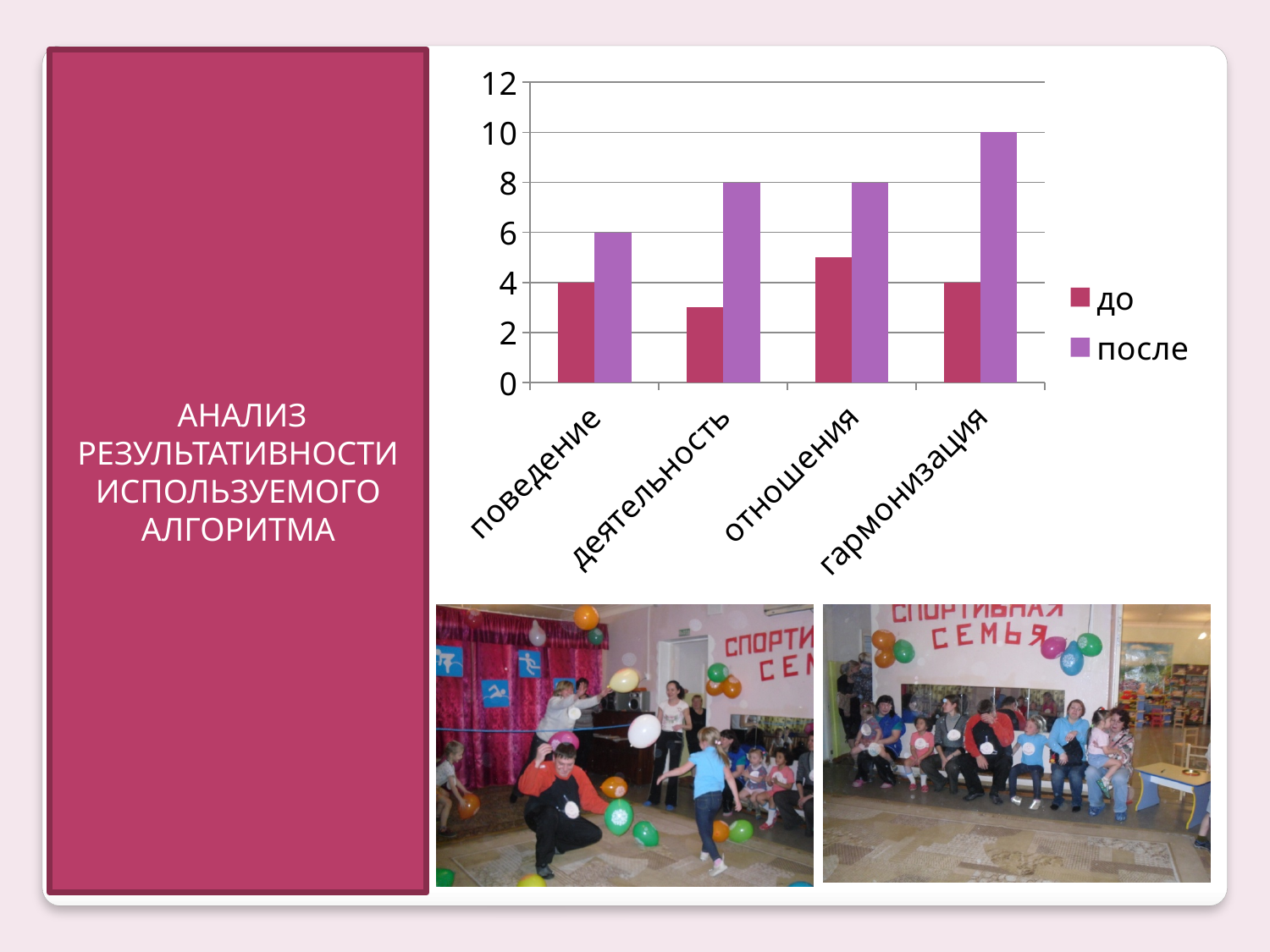
Which is larger: the "после" value for гармонизация or the "после" value for поведение? гармонизация What is the difference between the "после" and "до" values for гармонизация? 6 What is the value of the "после" bar for гармонизация? 10 What is the value of the "после" bar for поведение? 6 Which category has the lowest "до" value? деятельность Is the "до" value for деятельность greater or less than 4? less What is the value of the "после" bar for деятельность? 8 Which category has the highest "после" value? гармонизация Is the "до" value for отношения greater or less than 4? greater How many series does the chart legend list? 2 How many categories are shown on the x axis of the chart? 4 What is the value of the "до" bar for поведение? 4